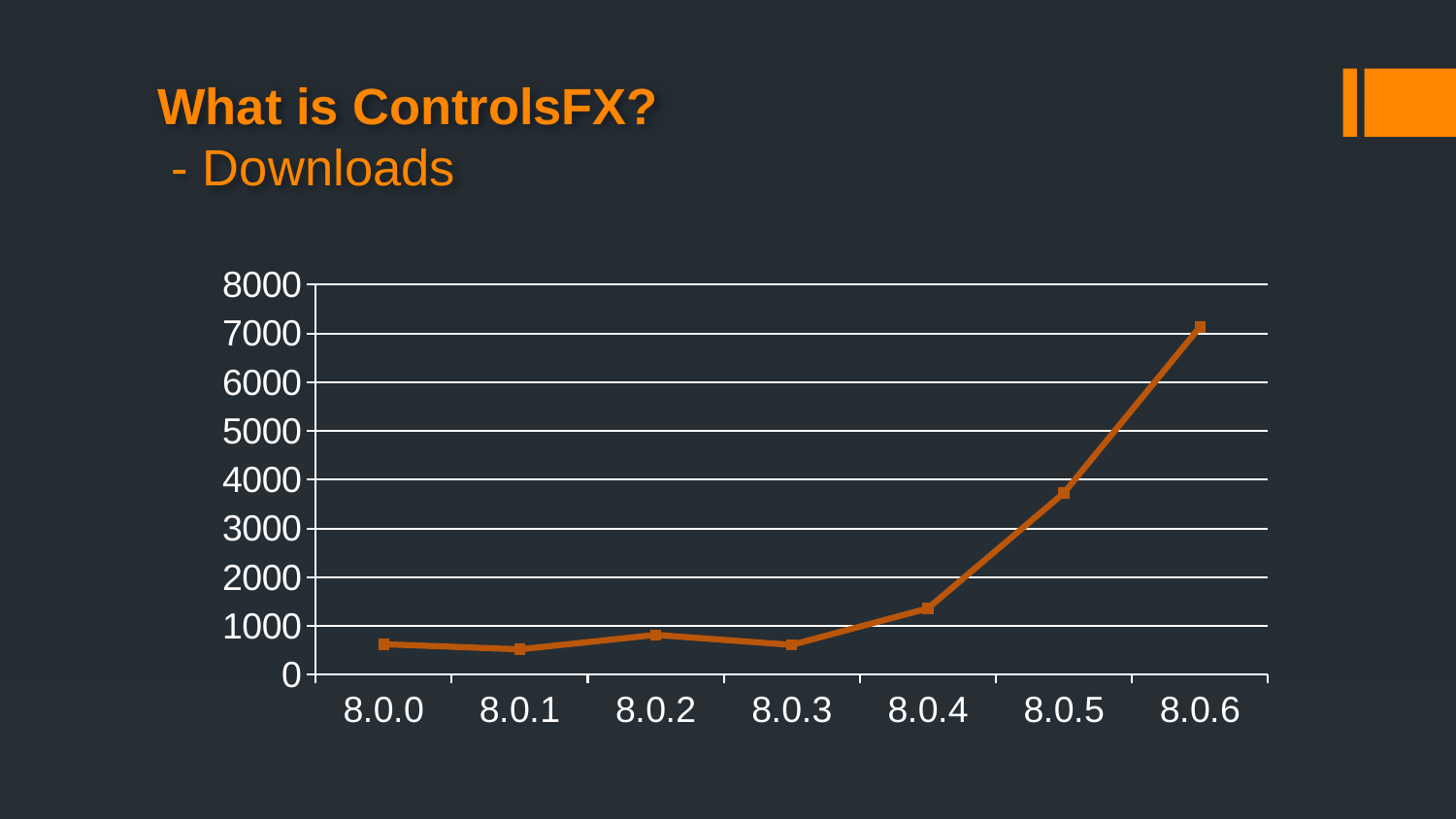
Which version has the highest value? 8.0.6 Do the values rise or fall from 8.0.3 to 8.0.6? rise What is the highest value shown on the y axis? 8000 How many versions are plotted along the x axis? 7 Is the value for 8.0.5 greater or less than 4000? less Is the value for 8.0.4 greater or less than 1000? greater Is the value for 8.0.2 greater or less than 1000? less Which has the larger value, 8.0.4 or 8.0.5? 8.0.5 What kind of chart is shown on the slide? line chart Which has the larger value, 8.0.2 or 8.0.6? 8.0.6